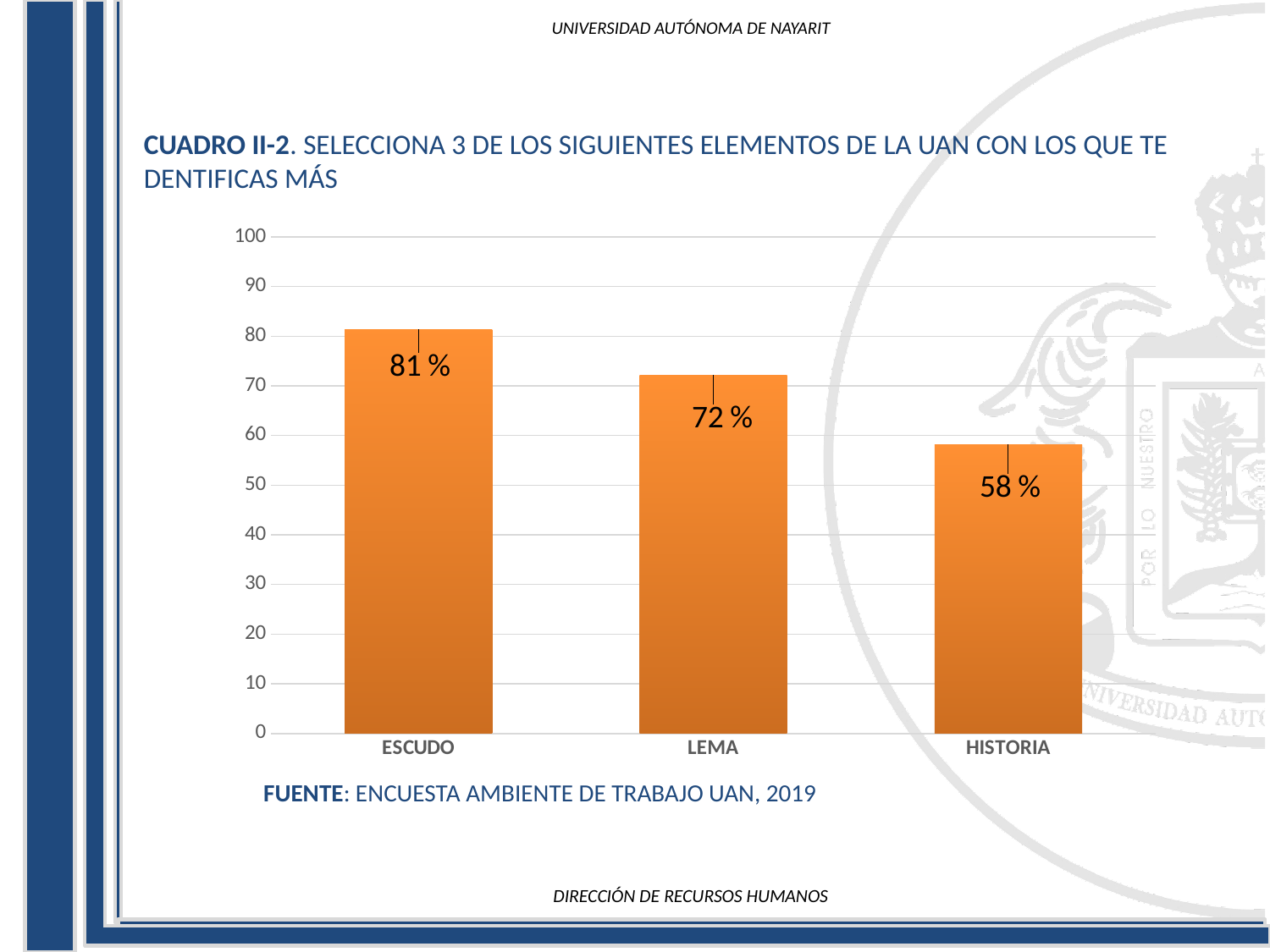
Do the values rise or fall from left to right across the categories? fall Which category has the highest value? ESCUDO What kind of chart is shown on the slide? bar chart What is the value for LEMA? 72 % Which category has the lowest value? HISTORIA What is the value for HISTORIA? 58 % Is the value for HISTORIA greater or less than 60? less How many categories are shown in the chart? 3 What is the difference between the values for ESCUDO and HISTORIA? 23 % Which is larger, the value for LEMA or the value for HISTORIA? LEMA What is the difference between the values for ESCUDO and LEMA? 9 % What is the value for ESCUDO? 81 %